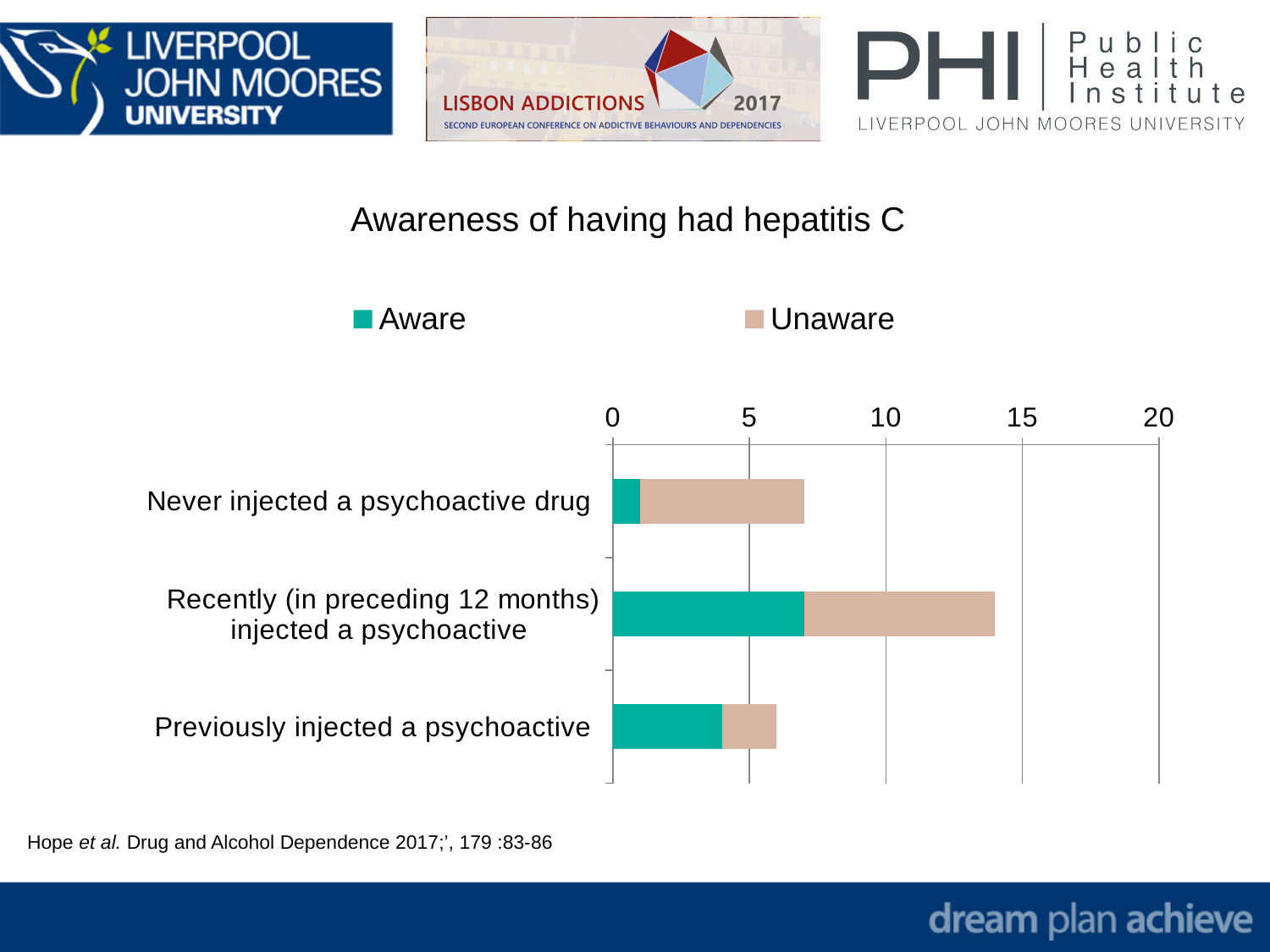
For 'Previously injected a psychoactive', which is larger, the Aware segment or the Unaware segment? Aware What is the title of the chart? Awareness of having had hepatitis C Which category has the smallest Aware value? Never injected a psychoactive drug Which category has the largest Aware value? Recently (in preceding 12 months) injected a psychoactive Is the Aware value for 'Recently (in preceding 12 months) injected a psychoactive' greater or less than 5? greater How many categories are shown on the chart? 3 Which category has the longest total bar? Recently (in preceding 12 months) injected a psychoactive What are the two series named in the legend? Aware and Unaware Is the total bar for 'Recently (in preceding 12 months) injected a psychoactive' greater or less than 10? greater How many series does the legend list? 2 Is the Aware value for 'Never injected a psychoactive drug' greater or less than 5? less What kind of chart is shown on the slide? stacked bar chart